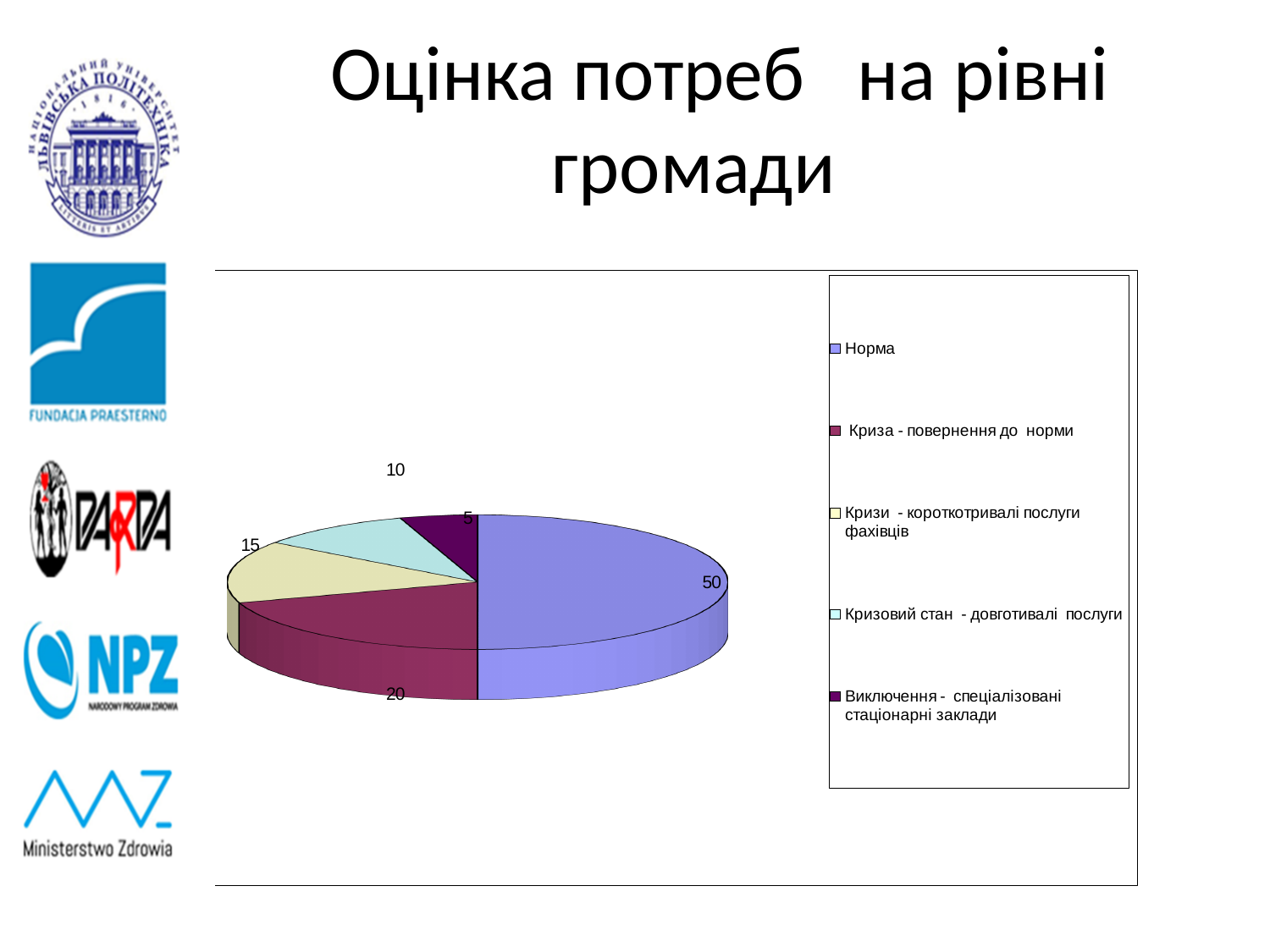
What is the value for the "Криза - повернення до норми" slice? 20 Which is larger: the value for "Кризи - короткотривалі послуги фахівців" or for "Кризовий стан - довготивалі послуги"? Кризи - короткотривалі послуги фахівців What colour is the "Норма" slice in the pie chart? light purple What kind of chart is shown on the slide? pie chart How many slices does the pie chart have? 5 Which category has the smallest slice of the pie? Виключення - спеціалізовані стаціонарні заклади What share of the pie does the "Кризовий стан - довготивалі послуги" slice represent? 10% What is the value for the "Кризи - короткотривалі послуги фахівців" slice? 15 What is the difference between the values for "Норма" and "Криза - повернення до норми"? 30 What is the value for the "Норма" slice? 50 Which category has the largest slice of the pie? Норма What is the value for the "Виключення - спеціалізовані стаціонарні заклади" slice? 5